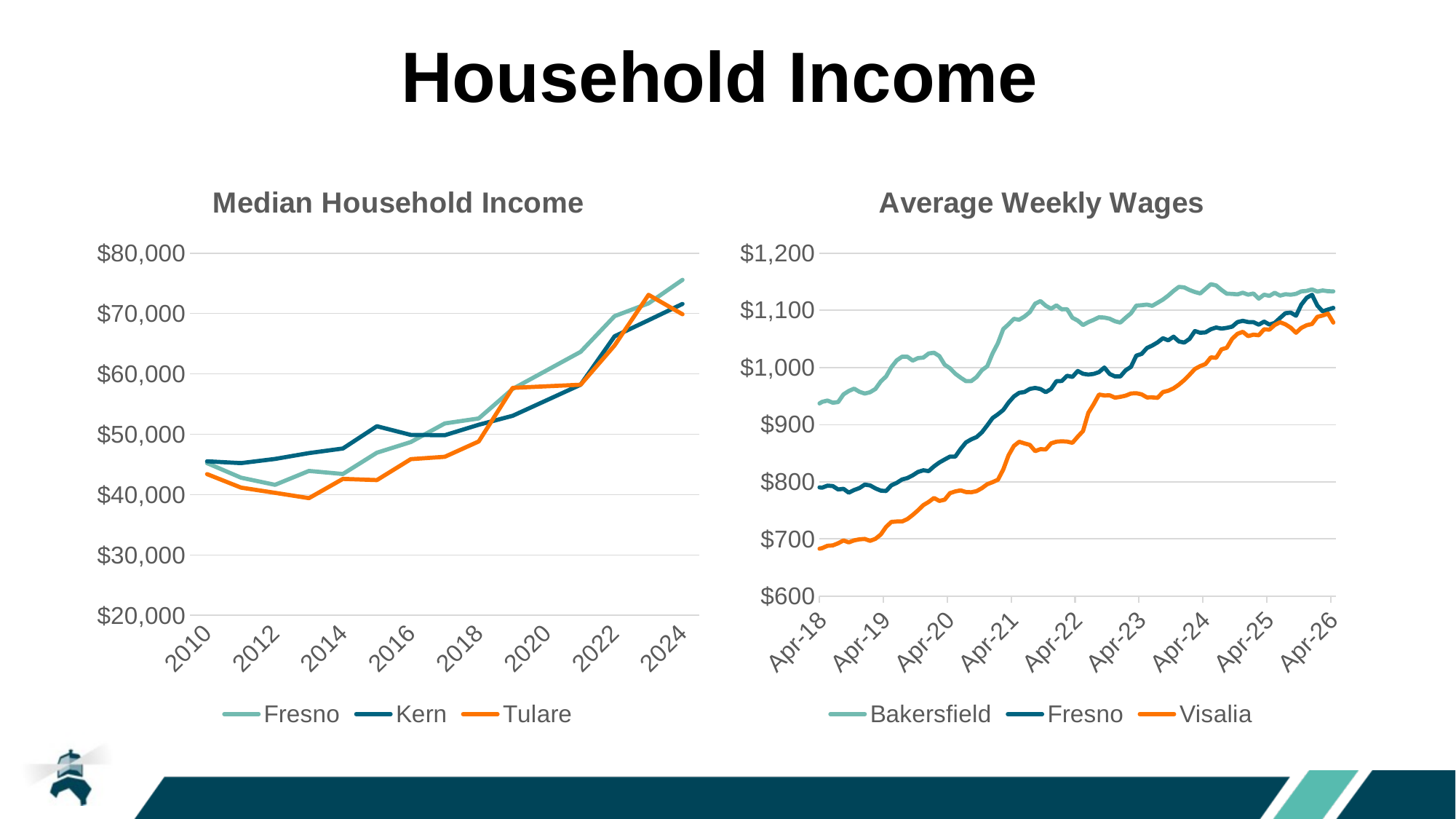
In the Median Household Income chart, which series has the highest value in 2024? Fresno In the Median Household Income chart, is the value for Tulare in 2013 greater or less than $40,000? less In the Average Weekly Wages chart, is the value for Bakersfield at Apr-24 greater or less than $1,100? greater In the Average Weekly Wages chart, which series has the highest value at Apr-18? Bakersfield In the Average Weekly Wages chart, which series has the lowest value at Apr-18? Visalia In the Median Household Income chart, which series has the lowest value in 2013? Tulare What kind of chart is the Median Household Income chart? line chart In the Average Weekly Wages chart, is the value for Visalia at Apr-18 greater or less than $700? less Which series are listed in the legend of the Average Weekly Wages chart? Bakersfield, Fresno, Visalia How many series does the legend of the Median Household Income chart list? 3 In the Median Household Income chart, do the values for Fresno generally rise or fall from 2010 to 2024? rise